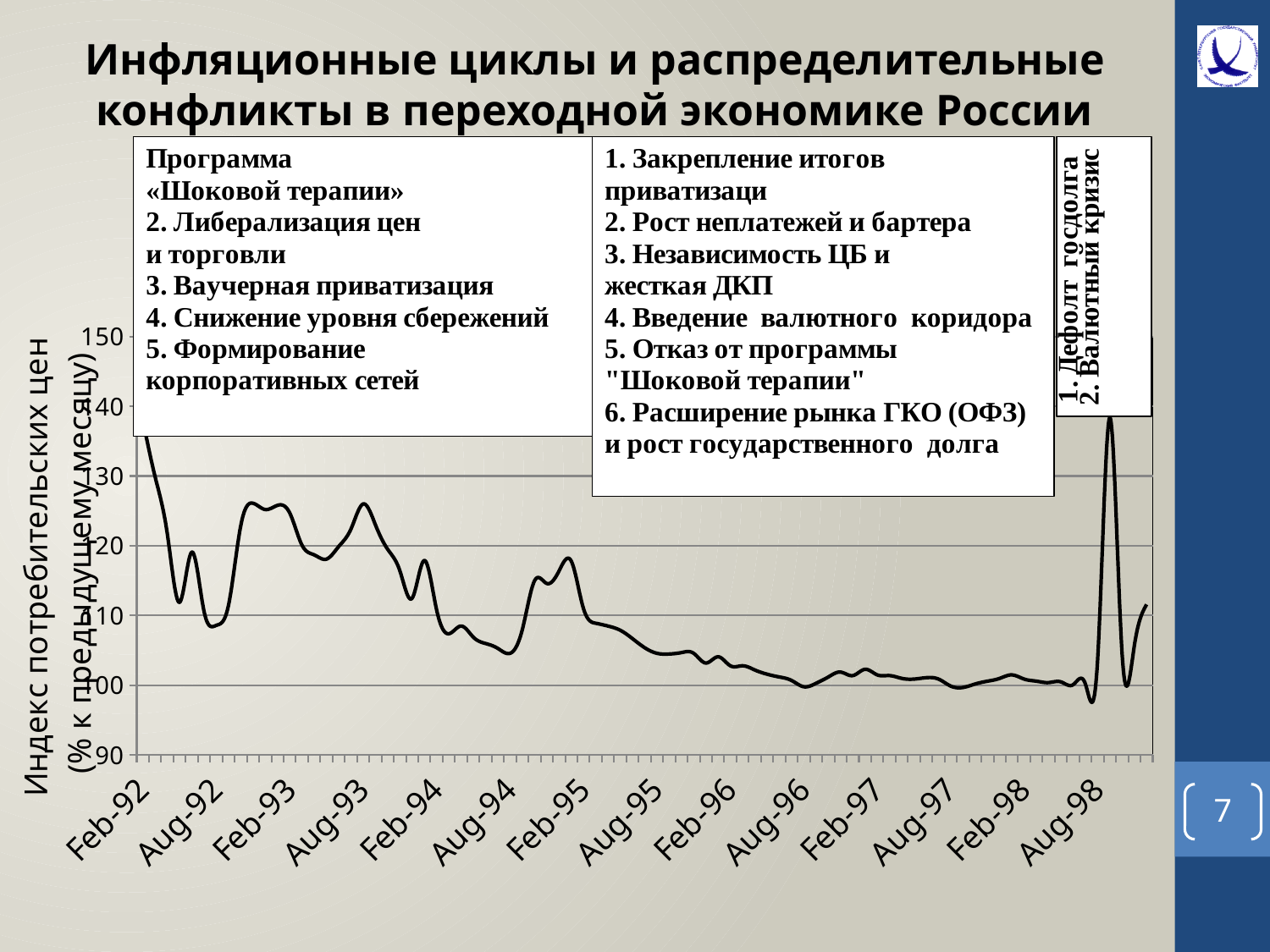
Which is larger, the value for Feb-92 or the value for Feb-96? Feb-92 Is the value for Feb-98 greater or less than 110? less What is the label of the vertical axis of the chart? Индекс потребительских цен (% к предыдущему месяцу) Overall, do the values rise or fall from Feb-92 to Aug-98? fall Is the value for Feb-92 greater or less than 130? greater How many date labels are shown along the x axis of the chart? 14 Is the value for Aug-96 greater or less than 110? less How many lines are plotted on the chart? 1 What kind of chart is shown on the slide? line chart